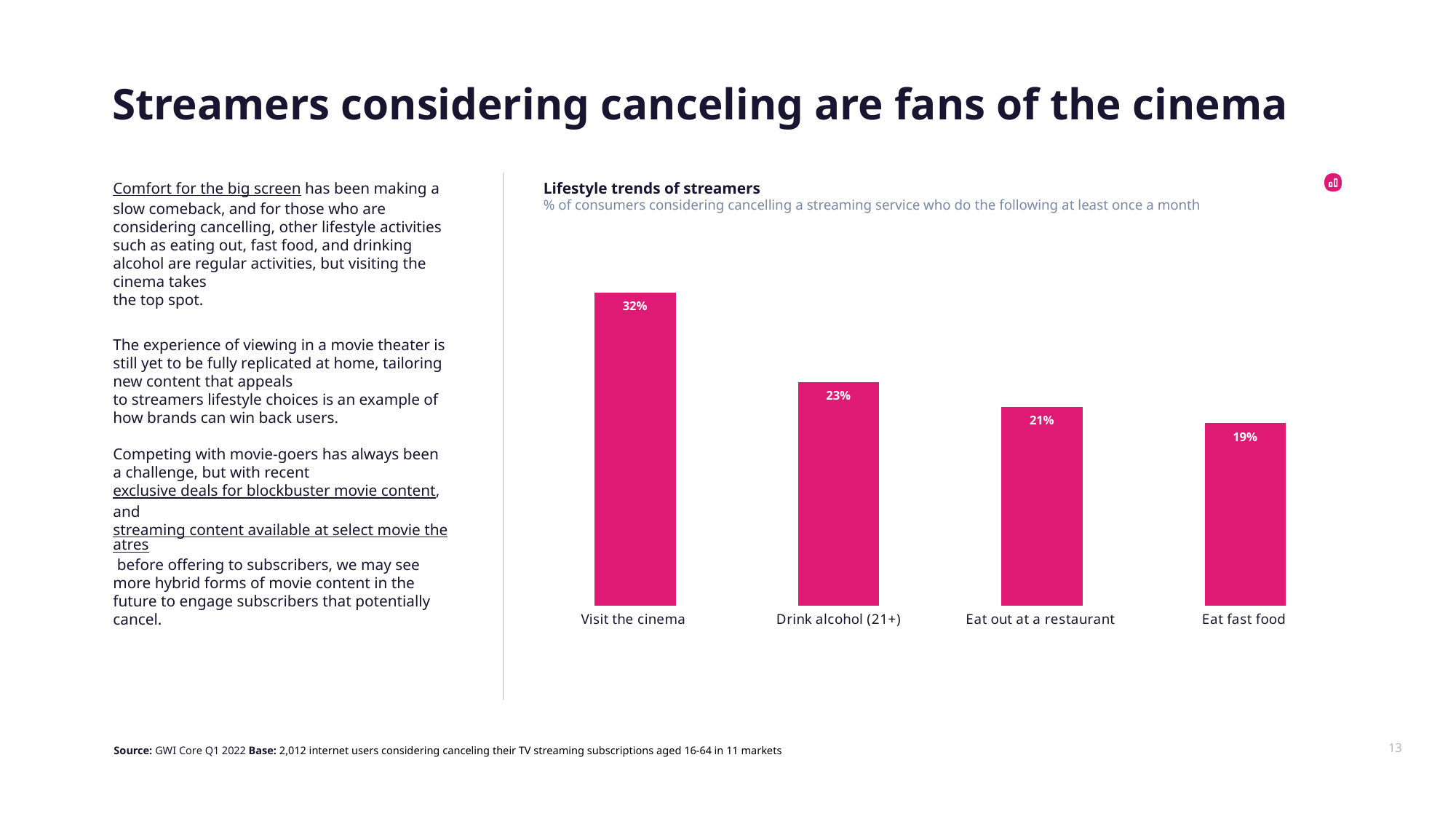
How many activity categories are shown in the chart? 4 What is the difference in percentage points between 'Visit the cinema' and 'Eat fast food'? 13 percentage points What is the value shown for 'Eat fast food'? 19% What is the title of the chart on the slide? Lifestyle trends of streamers Which activity has the lowest percentage in the chart? Eat fast food What is the value shown for 'Drink alcohol (21+)'? 23% What is the difference in percentage points between 'Drink alcohol (21+)' and 'Eat out at a restaurant'? 2 percentage points Which is larger, the value for 'Visit the cinema' or the value for 'Drink alcohol (21+)'? Visit the cinema What is the value shown for 'Eat out at a restaurant'? 21% Which activity has the highest percentage in the chart? Visit the cinema What type of chart is used to show the lifestyle trends of streamers? Bar chart What percentage of consumers considering cancelling a streaming service visit the cinema at least once a month? 32%